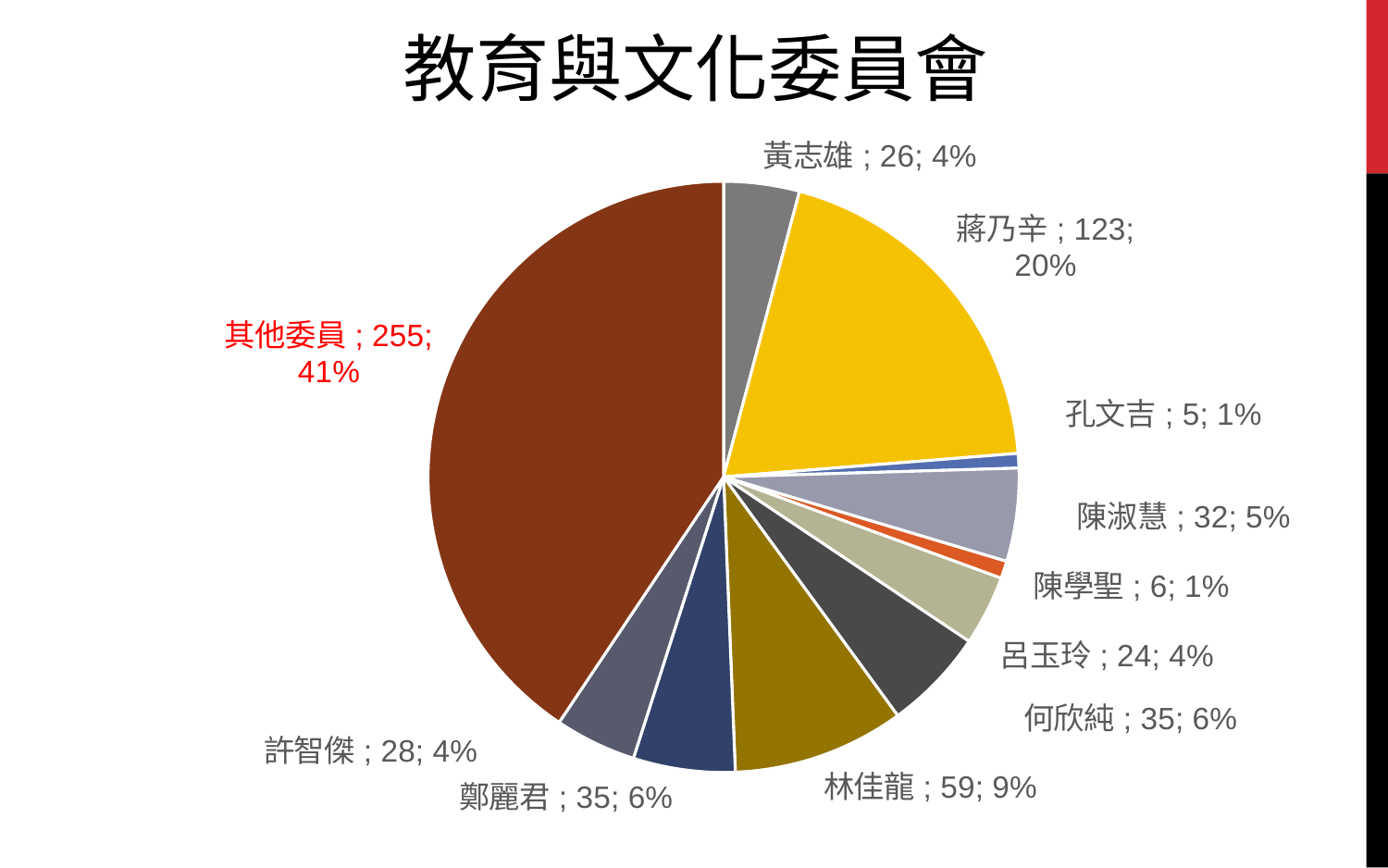
What share of the pie does 其他委員 represent? 41% What is the value for 蔣乃辛? 123 What is the difference between the values for 蔣乃辛 and 林佳龍? 64 Which category has the smallest slice? 孔文吉 What share of the pie does 何欣純 represent? 6% What is the title of the chart? 教育與文化委員會 What is the value for 呂玉玲? 24 What kind of chart is shown on the slide? pie chart Which is larger, the value for 陳淑慧 or the value for 許智傑? 陳淑慧 Which category has the largest slice? 其他委員 What is the value for 林佳龍? 59 How many slices does the pie chart have? 11